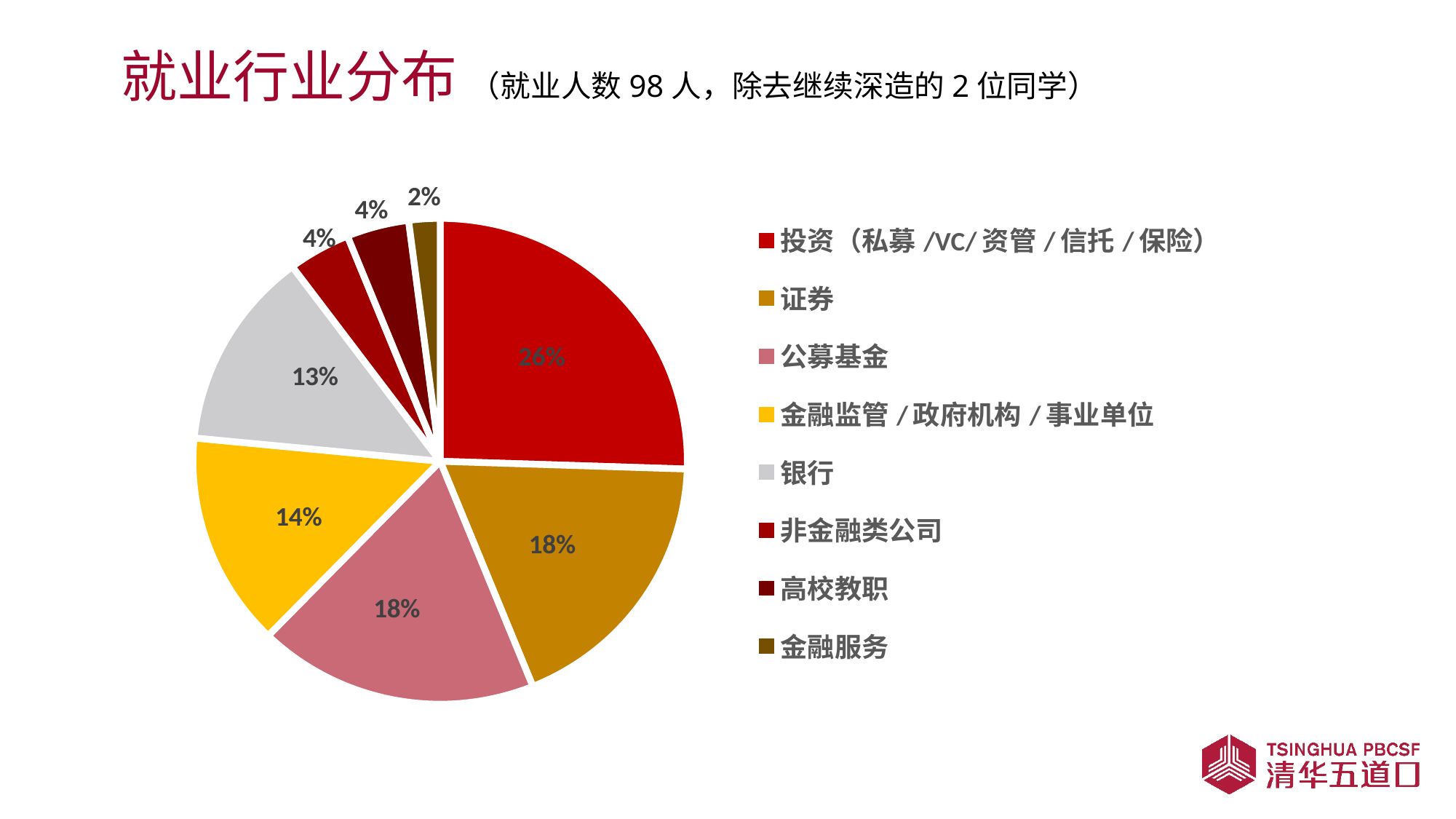
Which category has the largest slice of the pie? 投资（私募/VC/资管/信托/保险） Which category has the smallest slice of the pie? 金融服务 What share of the pie does 金融服务 hold? 2% How many categories does the pie chart show? 8 What is the title of the chart on the slide? 就业行业分布 What share of the pie does 银行 hold? 13% What is the combined share of 证券 and 公募基金? 36% Which is larger, the share for 金融监管/政府机构/事业单位 or the share for 银行? 金融监管/政府机构/事业单位 What type of chart is shown on the slide? pie chart What share of the pie does 投资（私募/VC/资管/信托/保险） hold? 26% What is the difference in percentage points between 投资（私募/VC/资管/信托/保险） and 证券? 8